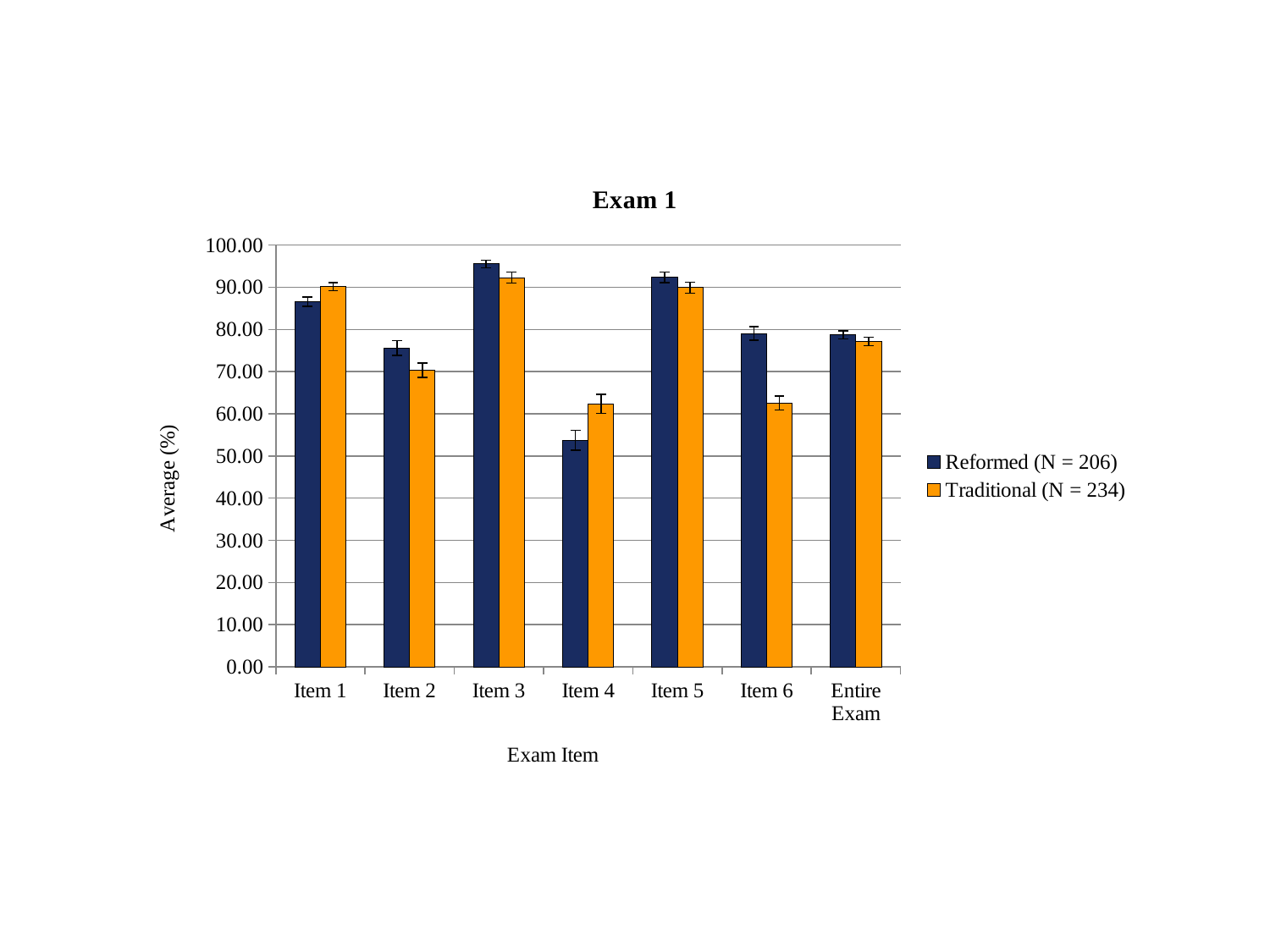
Is the Reformed (N = 206) value for Item 4 greater or less than 60.00? less What is the title of the chart? Exam 1 Is the Reformed (N = 206) value for Item 3 greater or less than 90.00? greater How many categories are shown on the x axis? 7 Is the Traditional (N = 234) value for Item 6 greater or less than 70.00? less What kind of chart is shown on the slide? bar chart Which exam item has the highest value for the Reformed (N = 206) series? Item 3 How many series does the legend list? 2 Which exam item has the lowest value for the Reformed (N = 206) series? Item 4 What is the label of the y axis? Average (%) For Item 6, which series has the larger value, Reformed (N = 206) or Traditional (N = 234)? Reformed (N = 206) For Item 4, which series has the larger value, Reformed (N = 206) or Traditional (N = 234)? Traditional (N = 234)